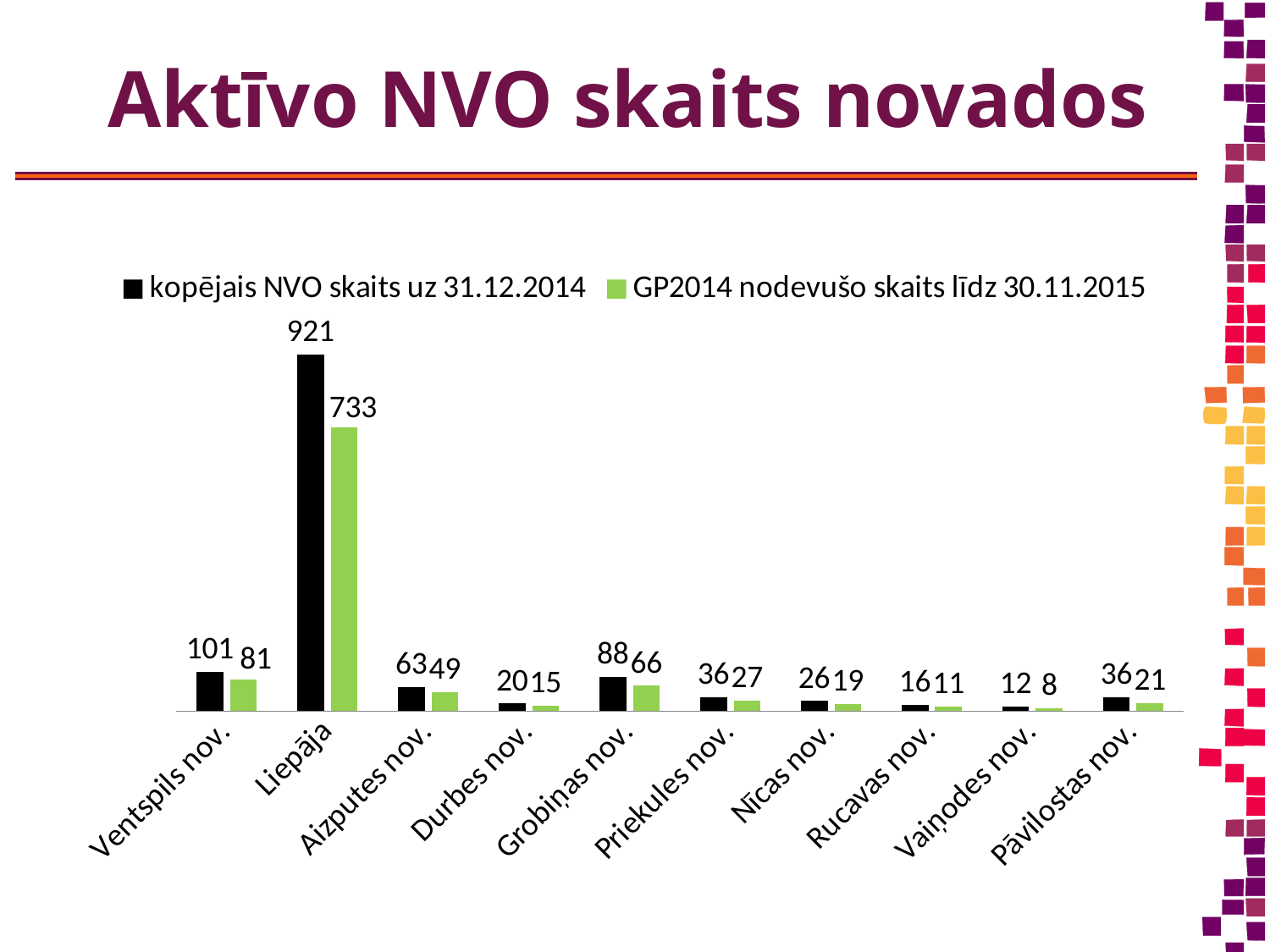
Which category has the lowest value for 'GP2014 nodevušo skaits līdz 30.11.2015'? Vaiņodes nov. What is the value of 'kopējais NVO skaits uz 31.12.2014' for Grobiņas nov.? 88 What is the difference between the two series values for Liepāja? 188 What is the title of the slide? Aktīvo NVO skaits novados Which is larger: 'kopējais NVO skaits uz 31.12.2014' for Grobiņas nov. or for Aizputes nov.? Grobiņas nov. What is the difference between 'kopējais NVO skaits uz 31.12.2014' for Ventspils nov. and Aizputes nov.? 38 How many series does the legend list? 2 How many categories are shown on the x axis? 10 What kind of chart is shown on the slide? bar chart What is the value of 'GP2014 nodevušo skaits līdz 30.11.2015' for Ventspils nov.? 81 Which category has the highest value for 'kopējais NVO skaits uz 31.12.2014'? Liepāja What is the value of 'kopējais NVO skaits uz 31.12.2014' for Liepāja? 921